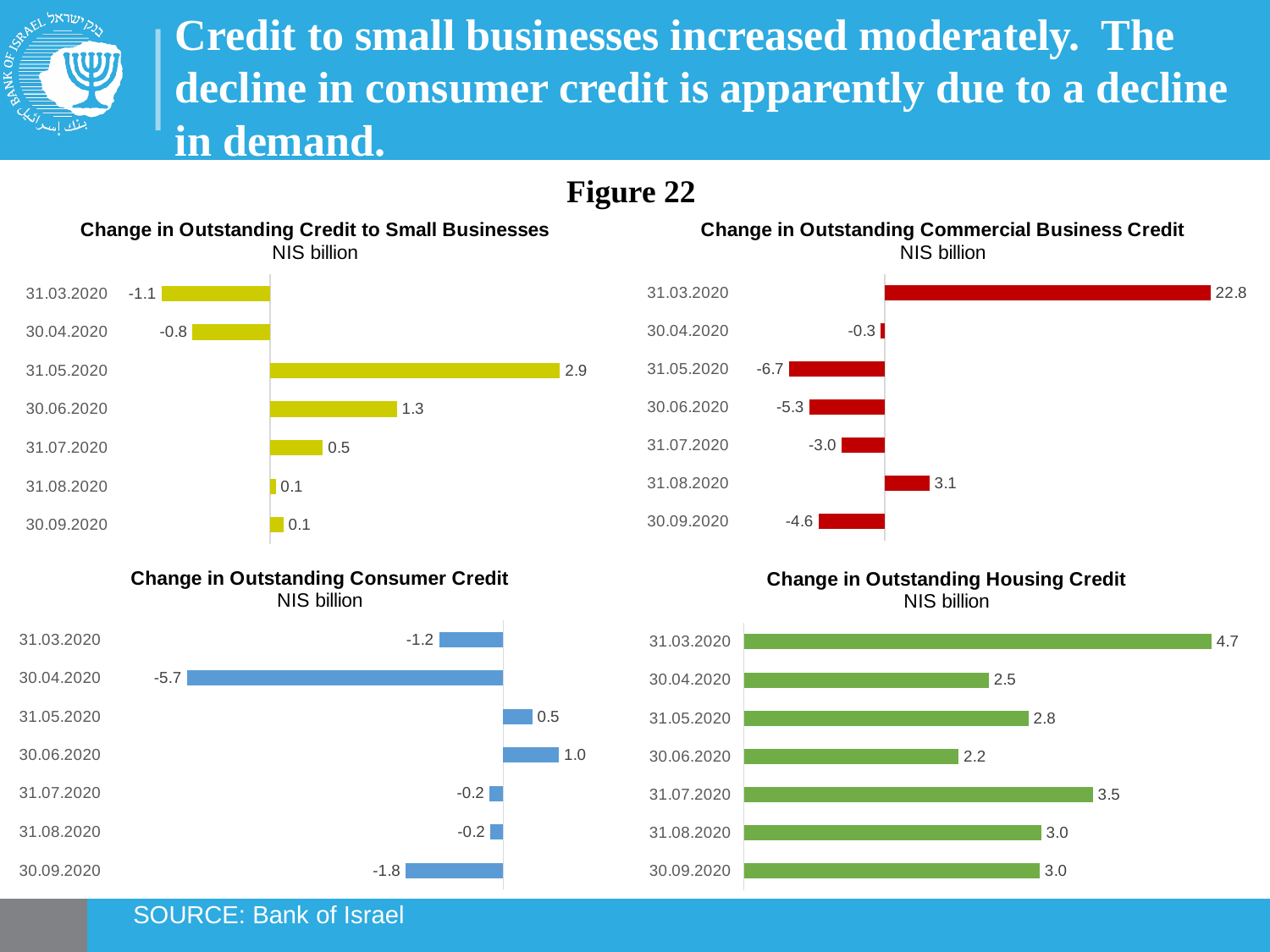
In the 'Change in Outstanding Consumer Credit' chart, which date has the lowest value? 30.04.2020 In the 'Change in Outstanding Consumer Credit' chart, what is the value for 30.04.2020? -5.7 In the 'Change in Outstanding Housing Credit' chart, which date has the highest value? 31.03.2020 In the 'Change in Outstanding Credit to Small Businesses' chart, what is the value for 31.05.2020? 2.9 In the 'Change in Outstanding Commercial Business Credit' chart, which date has the lowest value? 31.05.2020 In the 'Change in Outstanding Credit to Small Businesses' chart, which is larger, the value for 30.06.2020 or 31.07.2020? 30.06.2020 What unit is stated under the title of each of the four charts? NIS billion How many dates are shown in the 'Change in Outstanding Commercial Business Credit' chart? 7 In the 'Change in Outstanding Housing Credit' chart, what is the value for 31.07.2020? 3.5 In the 'Change in Outstanding Commercial Business Credit' chart, what is the value for 31.03.2020? 22.8 In the 'Change in Outstanding Housing Credit' chart, what is the difference between the values for 31.03.2020 and 30.06.2020? 2.5 What type of chart is the 'Change in Outstanding Consumer Credit' chart? Bar chart